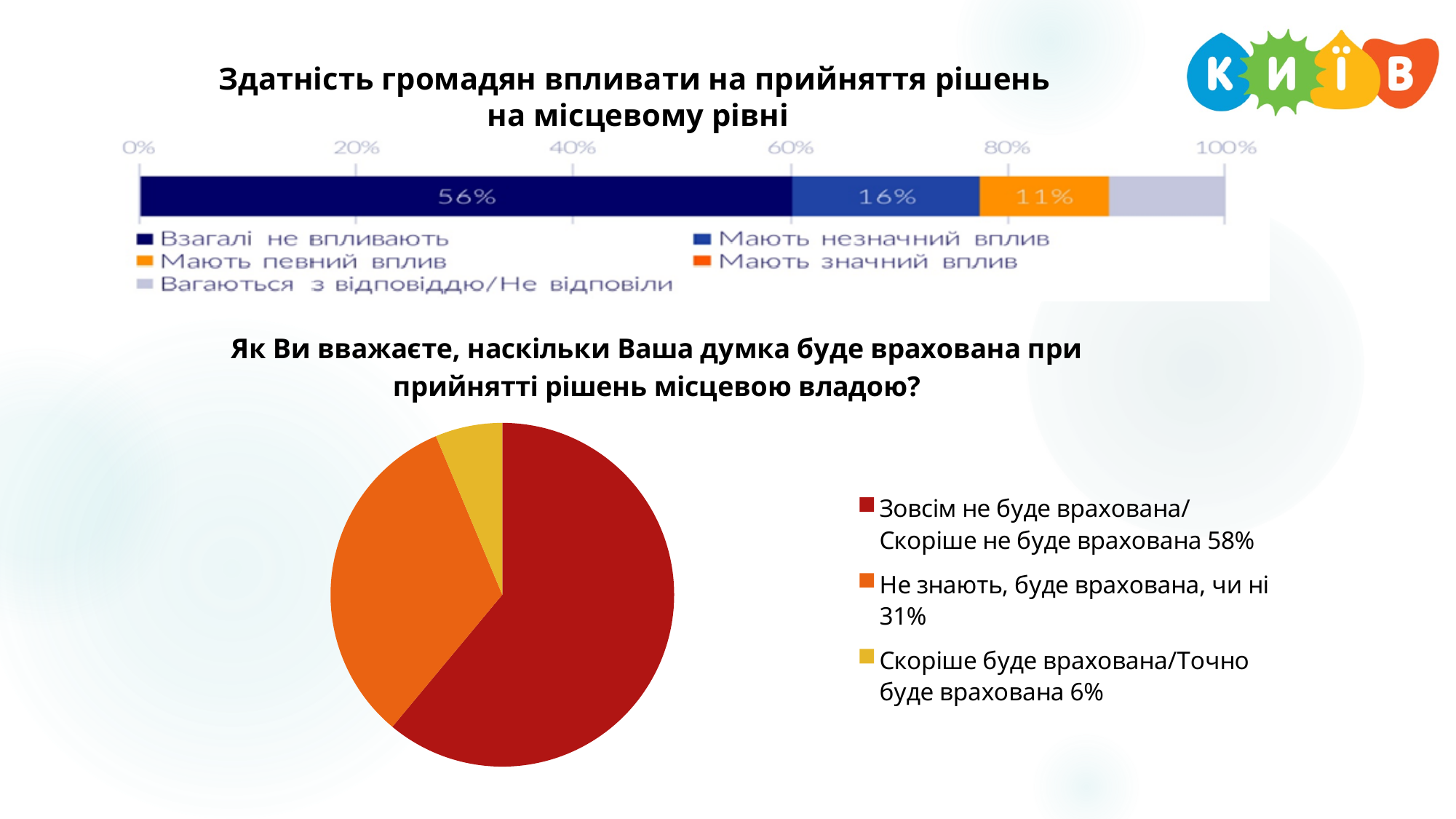
In the top chart 'Здатність громадян впливати на прийняття рішень на місцевому рівні', what is the value for 'Мають незначний вплив'? 16% In the top chart 'Здатність громадян впливати на прийняття рішень на місцевому рівні', how many entries does the legend list? 5 In the bottom pie chart, what share is 'Зовсім не буде врахована/Скоріше не буде врахована'? 58% In the top chart 'Здатність громадян впливати на прийняття рішень на місцевому рівні', what is the difference between 'Взагалі не впливають' and 'Мають незначний вплив'? 40% In the bottom pie chart, how many slices are there? 3 In the top chart 'Здатність громадян впливати на прийняття рішень на місцевому рівні', which category has the largest segment? Взагалі не впливають In the top chart 'Здатність громадян впливати на прийняття рішень на місцевому рівні', what is the value for 'Взагалі не впливають'? 56% In the bottom pie chart, what is the value for 'Не знають, буде врахована, чи ні'? 31% In the bottom pie chart, what is the difference between 'Зовсім не буде врахована/Скоріше не буде врахована' and 'Не знають, буде врахована, чи ні'? 27% In the bottom pie chart, which category has the smallest slice? Скоріше буде врахована/Точно буде врахована In the top chart 'Здатність громадян впливати на прийняття рішень на місцевому рівні', what is the value for 'Мають певний вплив'? 11% What kind of chart is the top chart 'Здатність громадян впливати на прийняття рішень на місцевому рівні'? Stacked bar chart